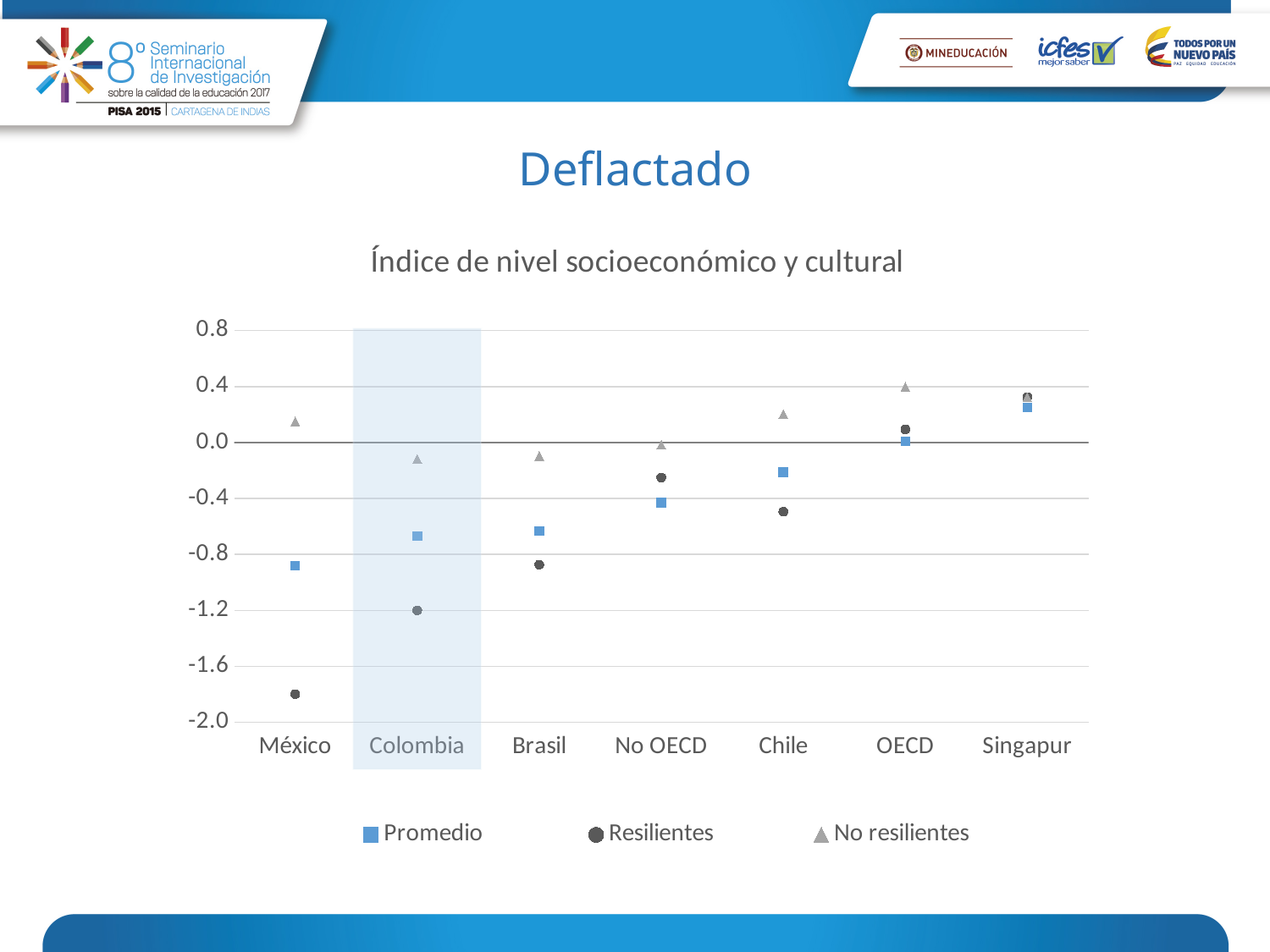
Which category has the lowest Promedio value? México Which category has the lowest Resilientes value? México Do the Promedio values generally rise or fall from México to Singapur along the x axis? rise Is the Resilientes value for México greater or less than -1.6? less How many categories are shown on the x axis? 7 Is the Promedio value for Colombia greater or less than -0.8? greater Which marker shape represents the No resilientes series in the legend? triangle How many series does the legend list? 3 What is the title of the chart? Índice de nivel socioeconómico y cultural Which is larger, the Promedio value for México or the Promedio value for Colombia? Colombia Is the Resilientes value for Chile greater or less than -0.4? less Which category has the highest No resilientes value? OECD